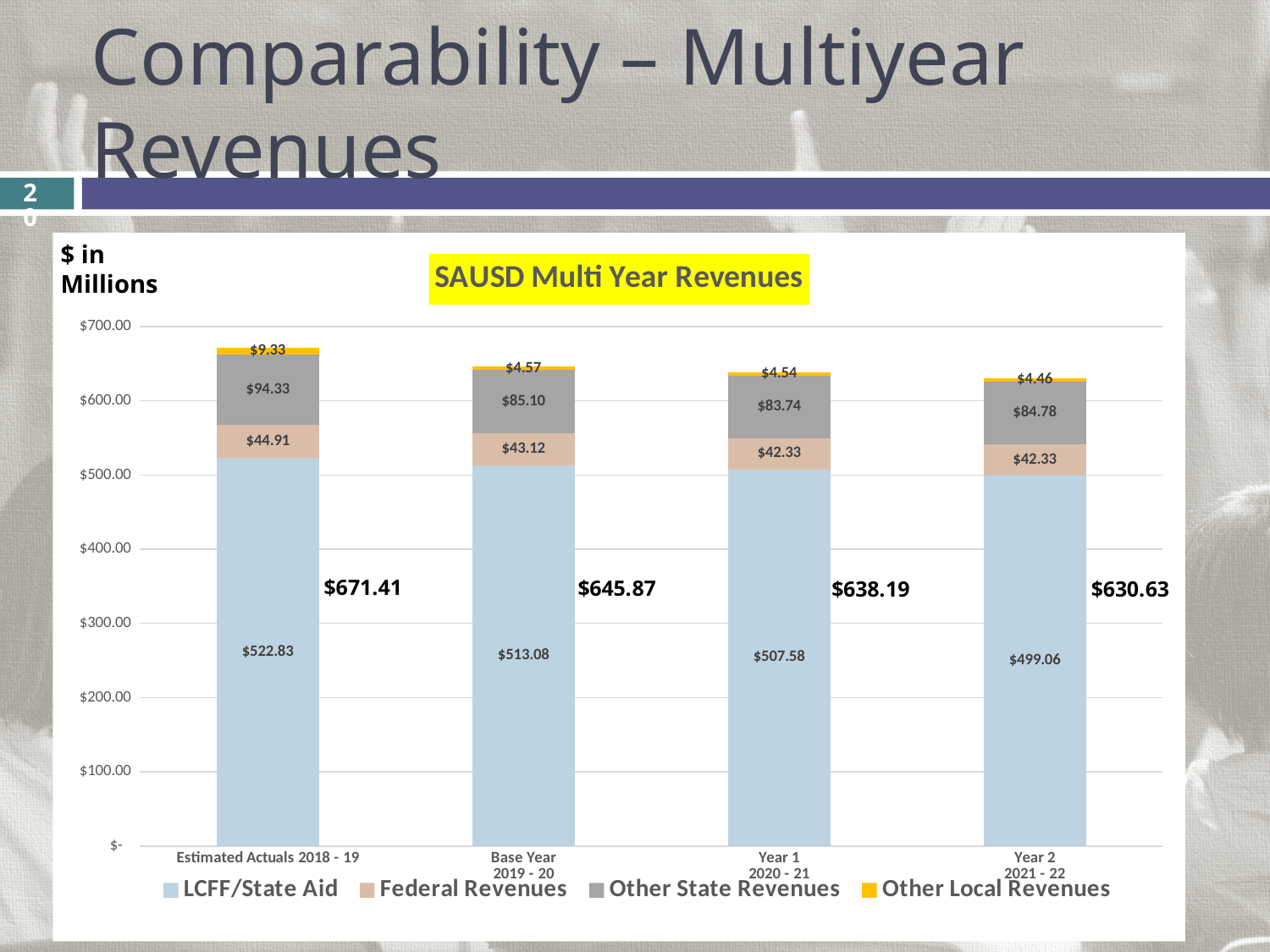
What is the difference between the LCFF/State Aid values for Estimated Actuals 2018 - 19 and Base Year 2019 - 20? $9.75 What is the total revenue shown for Year 1 2020 - 21? $638.19 Do the total revenues rise or fall from Estimated Actuals 2018 - 19 to Year 2 2021 - 22? Fall What is the LCFF/State Aid value for Estimated Actuals 2018 - 19? $522.83 Which year has the lowest LCFF/State Aid value? Year 2 2021 - 22 How many series does the legend list? 4 What is the Other State Revenues value for Base Year 2019 - 20? $85.10 What is the Other Local Revenues value for Year 2 2021 - 22? $4.46 Which is larger, Federal Revenues for Estimated Actuals 2018 - 19 or Federal Revenues for Year 1 2020 - 21? Estimated Actuals 2018 - 19 How many years (categories) are shown on the x axis? 4 What kind of chart is shown? Stacked bar chart Which year has the highest total revenue? Estimated Actuals 2018 - 19